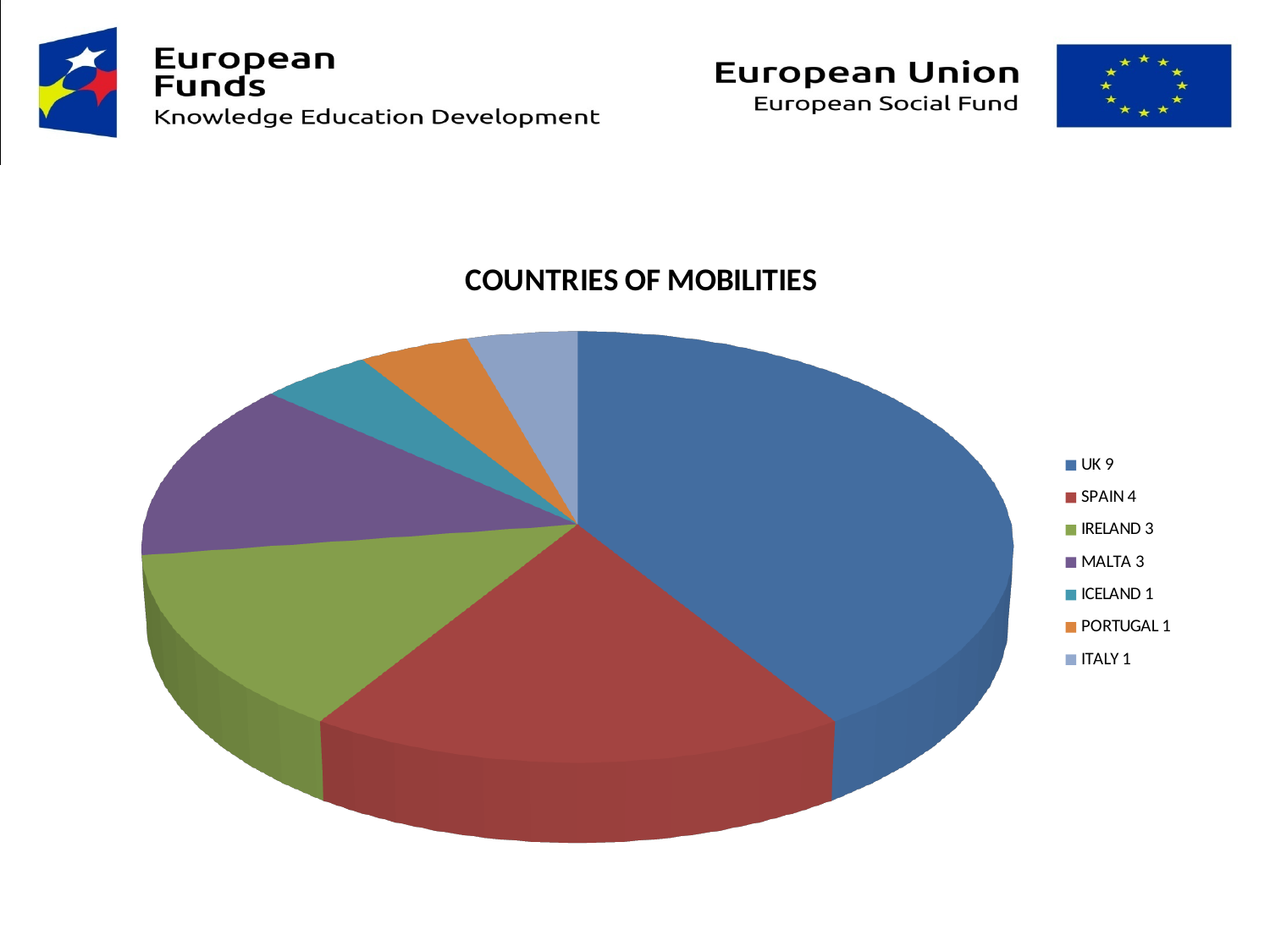
What is the value for SPAIN in the chart? 4 What is the value for ICELAND in the chart? 1 Which country has the largest slice of the pie? UK What colour is the UK slice in the pie chart? blue What is the difference between the values for UK and SPAIN? 5 What kind of chart is shown on the slide? pie chart What is the value for MALTA in the chart? 3 Which is larger, the value for IRELAND or the value for PORTUGAL? IRELAND How many countries are shown in the pie chart? 7 What is the total of all the values shown in the pie chart? 22 What is the title of the chart? COUNTRIES OF MOBILITIES What is the value for UK in the chart? 9